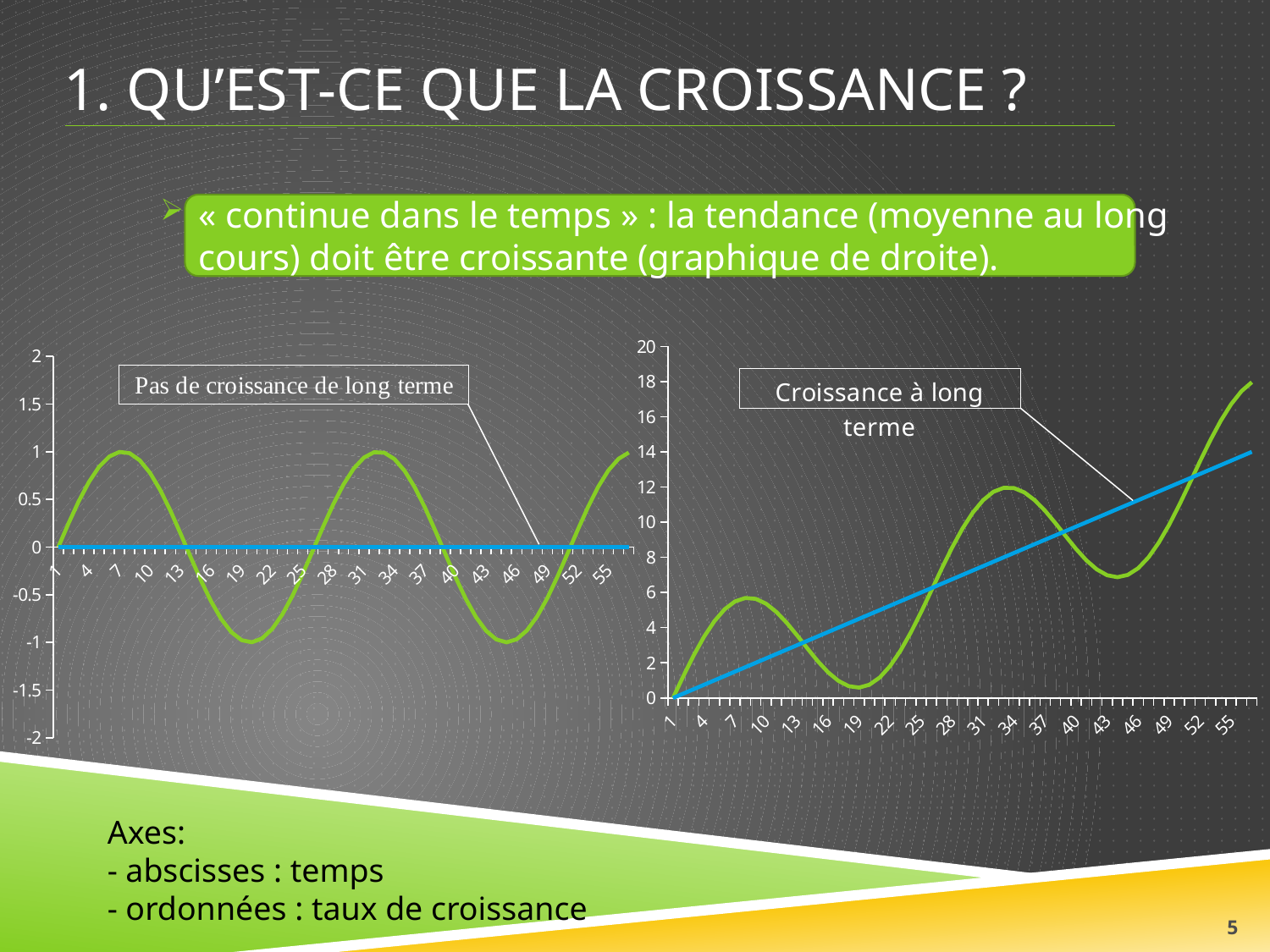
In the right chart, is the value of the blue line at x = 55 greater or less than 12? greater What does the text box inside the right chart say? Croissance à long terme In the left chart, at what value does the flat blue line sit? 0 In the right chart, does the blue straight line rise or fall along the x axis? rise In the left chart, what is the highest value reached by the green curve? 1 In the left chart, does the blue line rise, fall or stay flat along the x axis? stay flat What kind of chart is the right chart on the slide? line chart What kind of chart is the left chart on the slide? line chart In the right chart, is the value of the green curve at x = 19 greater or less than 2? less What does the text box inside the left chart say? Pas de croissance de long terme In the left chart, what is the lowest value reached by the green curve? -1 In the right chart, is the value of the green curve at x = 34 greater or less than 10? greater